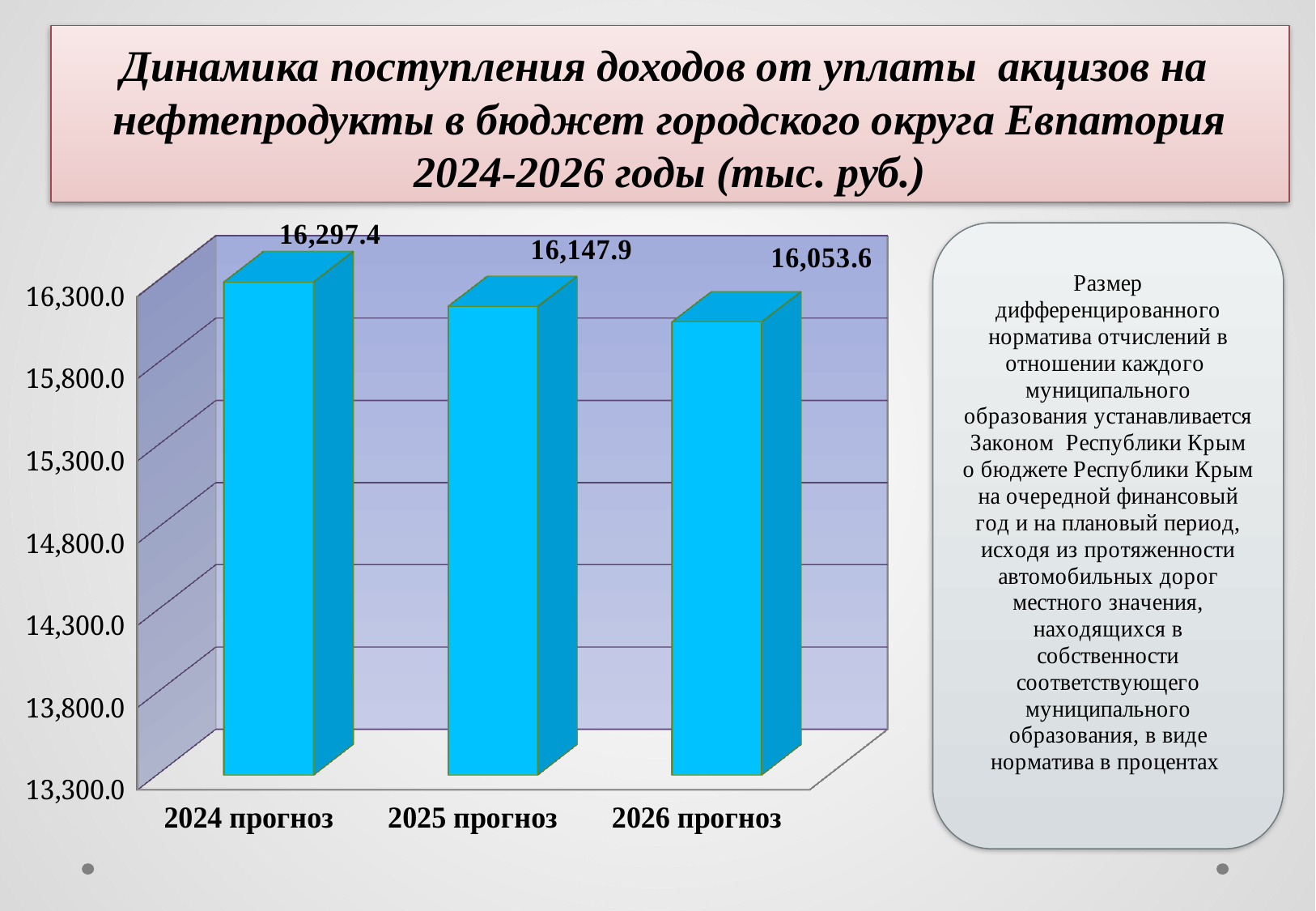
Which is larger, the value for 2024 прогноз or the value for 2026 прогноз? 2024 прогноз Is the value for 2026 прогноз greater or less than 15,800.0? greater Which category has the lowest value? 2026 прогноз What is the difference between the values for 2025 прогноз and 2026 прогноз? 94.3 What is the difference between the values for 2024 прогноз and 2025 прогноз? 149.5 What is the value for 2026 прогноз? 16,053.6 What is the value for 2024 прогноз? 16,297.4 Do the values rise or fall from 2024 прогноз to 2026 прогноз? fall What kind of chart is shown on the slide? bar chart What is the value for 2025 прогноз? 16,147.9 How many categories are shown on the x axis? 3 Which category has the highest value? 2024 прогноз